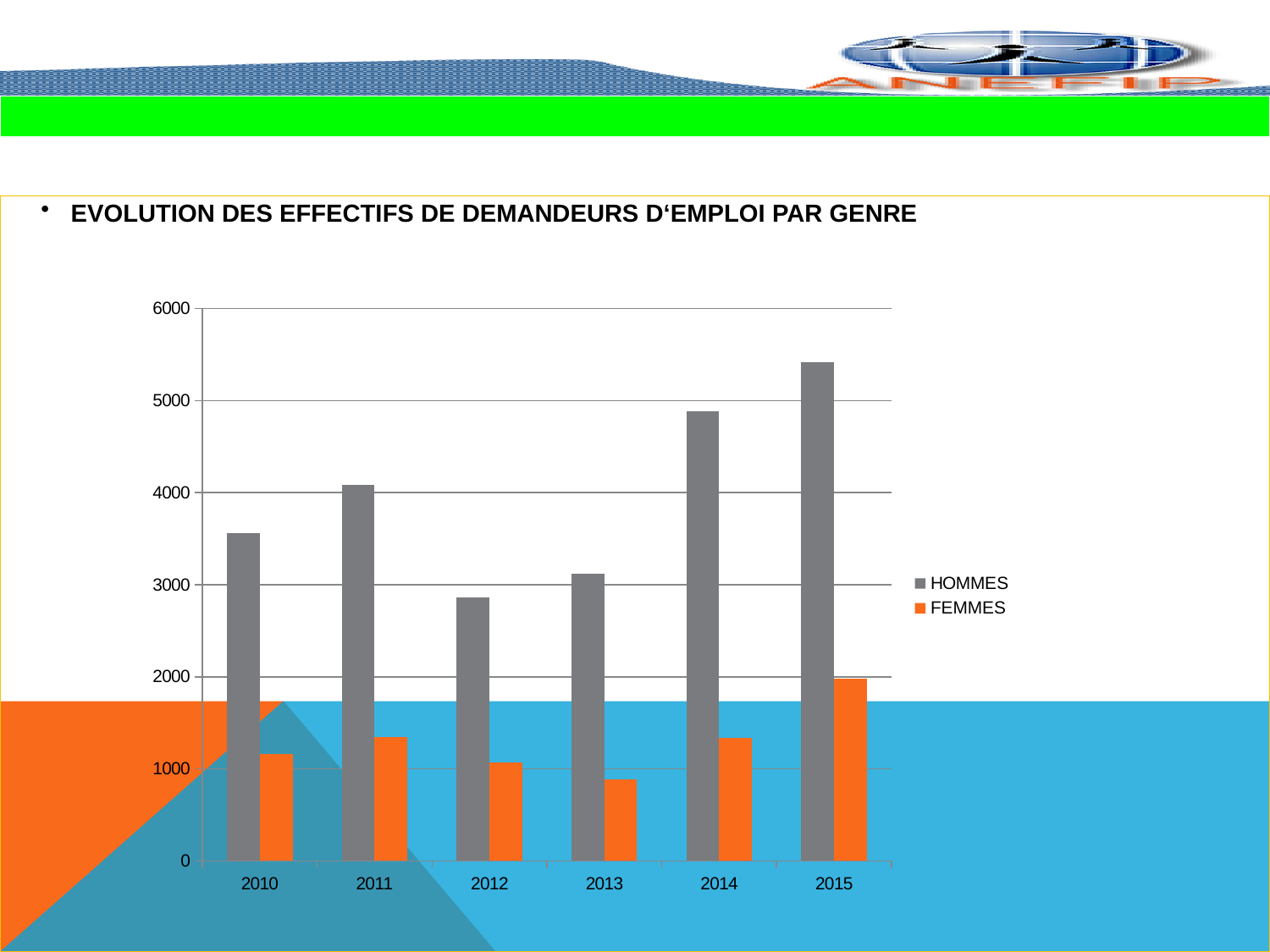
What kind of chart is shown on the slide? bar chart Which year has the lowest value for FEMMES? 2013 Which year has the highest value for HOMMES? 2015 How many series does the legend list? 2 Do the HOMMES values rise or fall from 2013 to 2015? rise Is the value for HOMMES in 2015 greater or less than 5000? greater Which is larger, the HOMMES value for 2010 or for 2013? 2010 Which year has the lowest value for HOMMES? 2012 How many years are shown on the x axis? 6 Is the value for FEMMES in 2013 greater or less than 1000? less Which year has the highest value for FEMMES? 2015 Is the value for HOMMES in 2012 greater or less than 3000? less